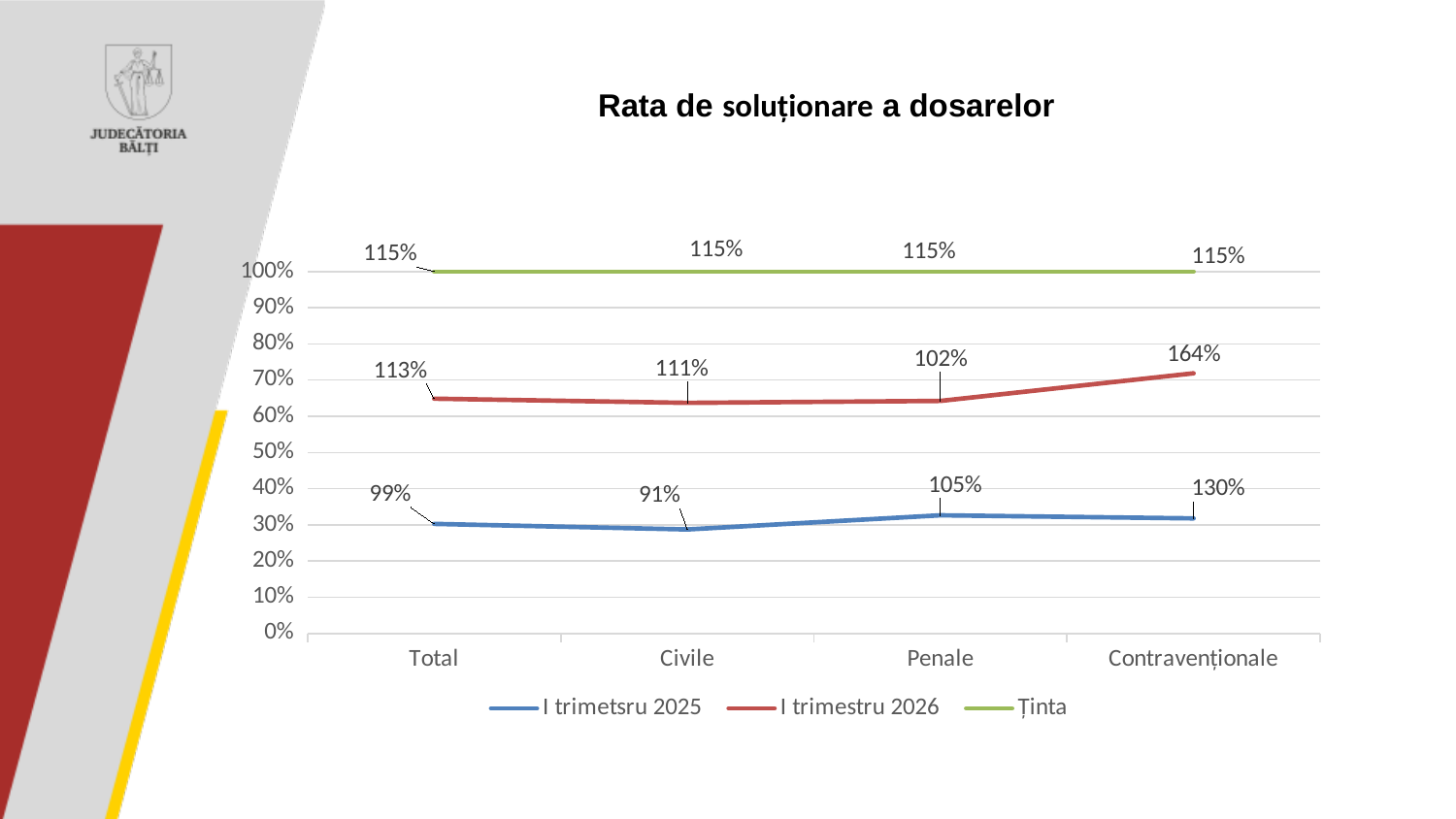
How many categories are shown on the x axis? 4 Which is larger for Penale: the I trimetsru 2025 value or the I trimestru 2026 value? I trimetsru 2025 What is the difference between the I trimestru 2026 and I trimetsru 2025 values for Total? 14% Which category has the highest value in the I trimetsru 2025 series? Contravenționale What is the value for Civile in the I trimetsru 2025 series? 91% What is the Ținta value for Total? 115% What is the value for Penale in the I trimestru 2026 series? 102% What is the value for Contravenționale in the I trimestru 2026 series? 164% How many series does the legend list? 3 What kind of chart is shown on the slide? Line chart Which category has the lowest value in the I trimestru 2026 series? Penale What is the title of the chart? Rata de soluționare a dosarelor